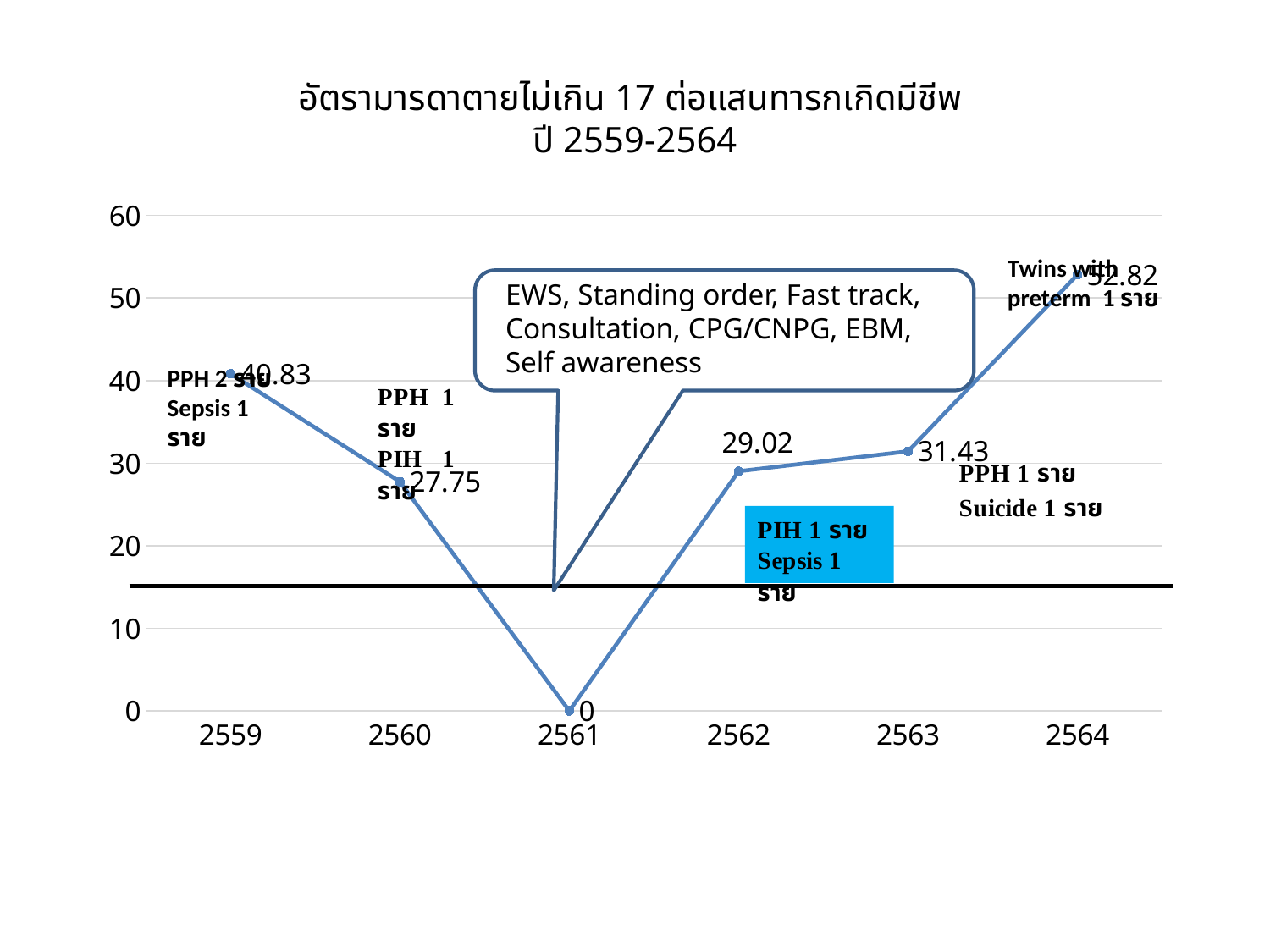
What is the difference between the values for 2559 and 2560? 13.08 Which is larger, the value for 2562 or the value for 2563? 2563 What kind of chart is shown on the slide? line chart What is the value for 2563? 31.43 Do the values rise or fall from 2561 to 2564? rise What is the value for 2560? 27.75 What is the value for 2561? 0 What is the value for 2562? 29.02 Which year has the highest value? 2564 Which year has the lowest value? 2561 How many years are plotted on the x axis? 6 What is the value for 2559? 40.83